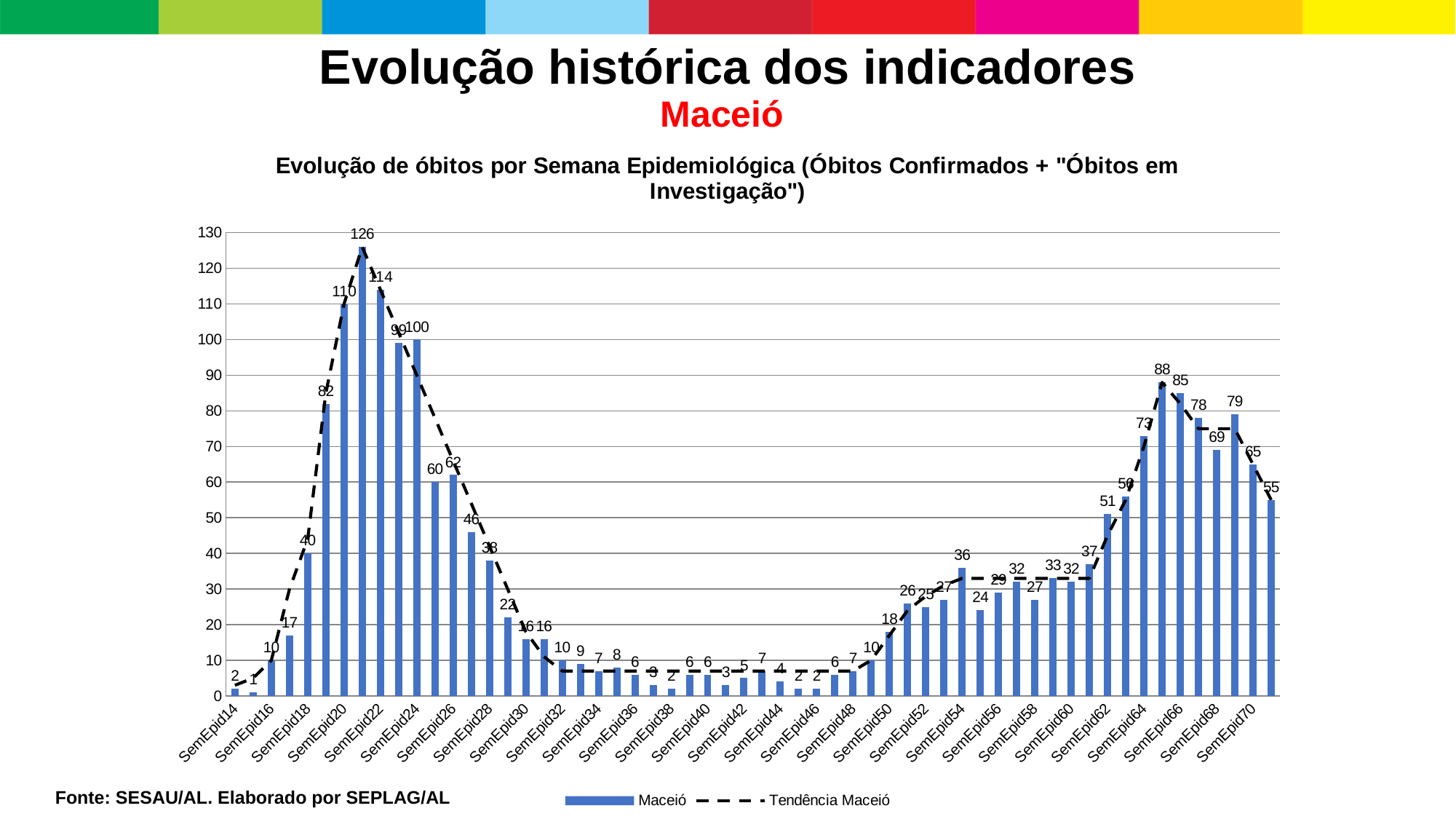
What is the difference between the values for SemEpid64 and SemEpid70? 8 What is the difference between the values for SemEpid22 and SemEpid20? 4 What is the value for SemEpid44? 4 What is the lowest value shown by any bar in the chart? 1 What is the value for SemEpid20? 110 Which has a larger value, SemEpid18 or SemEpid28? SemEpid18 What is the highest value shown by any bar in the chart? 126 How many series does the legend list? 2 What is the value for SemEpid64? 73 Do the values rise or fall from SemEpid22 to SemEpid44? fall Is the value for SemEpid62 greater or less than 50? greater What type of chart is shown on the slide? combination bar and line chart (bars with a dashed trend line)